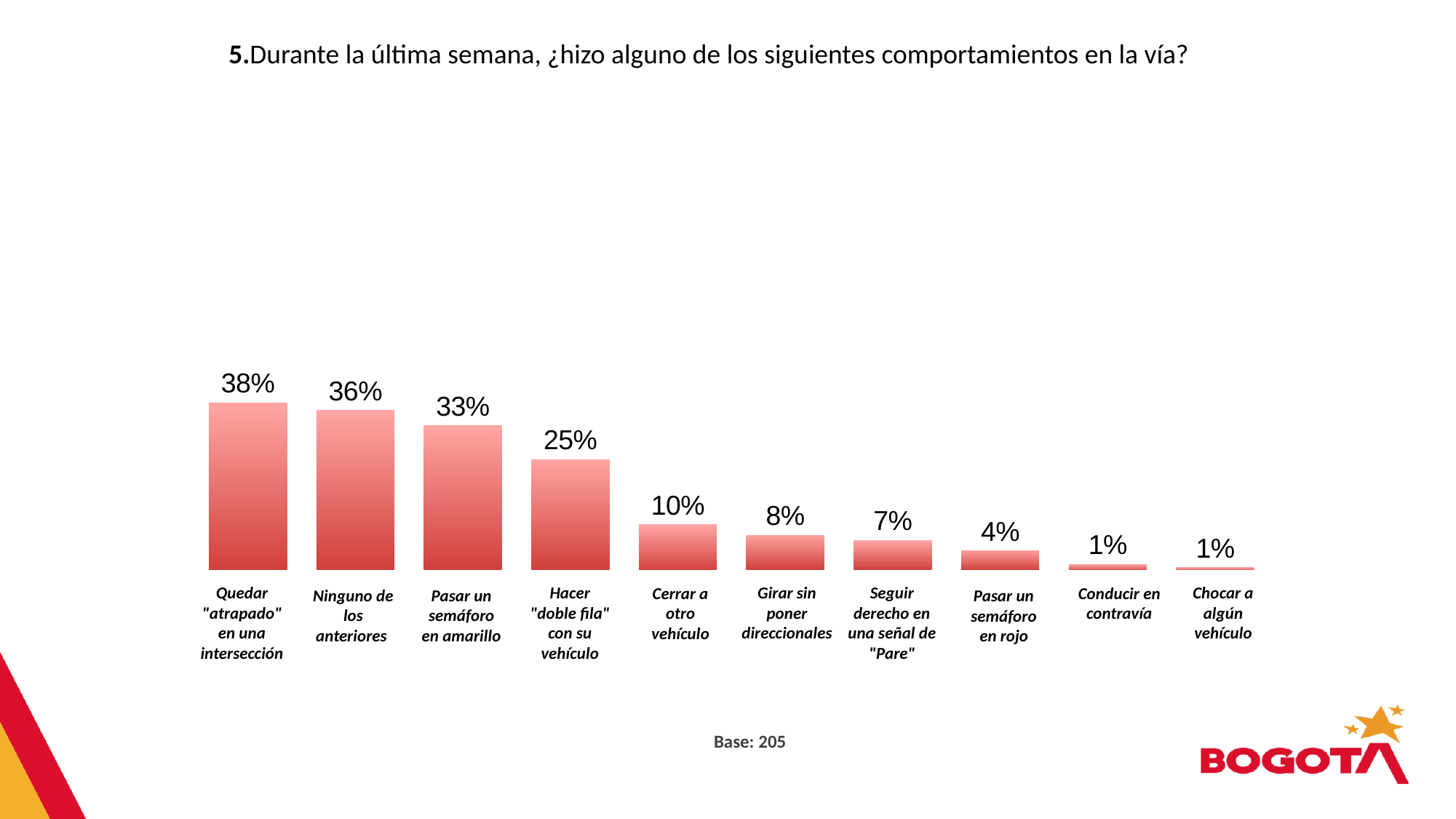
How many behaviour categories are shown on the chart? 10 What is the value shown for "Pasar un semáforo en amarillo"? 33% What percentage of respondents reported "Quedar "atrapado" en una intersección"? 38% What percentage is shown for "Hacer "doble fila" con su vehículo"? 25% What is the base (number of respondents) stated on the slide? 205 Which is larger, the value for "Girar sin poner direccionales" or the value for "Seguir derecho en una señal de "Pare""? Girar sin poner direccionales What is the difference between the values for "Ninguno de los anteriores" and "Cerrar a otro vehículo"? 26% What is the difference between the values for "Quedar "atrapado" en una intersección" and "Ninguno de los anteriores"? 2% Which behaviour has the highest percentage on the chart? Quedar "atrapado" en una intersección What is the value for "Pasar un semáforo en rojo"? 4% Do the values rise or fall from left to right across the chart? Fall What kind of chart is shown on the slide? Bar chart